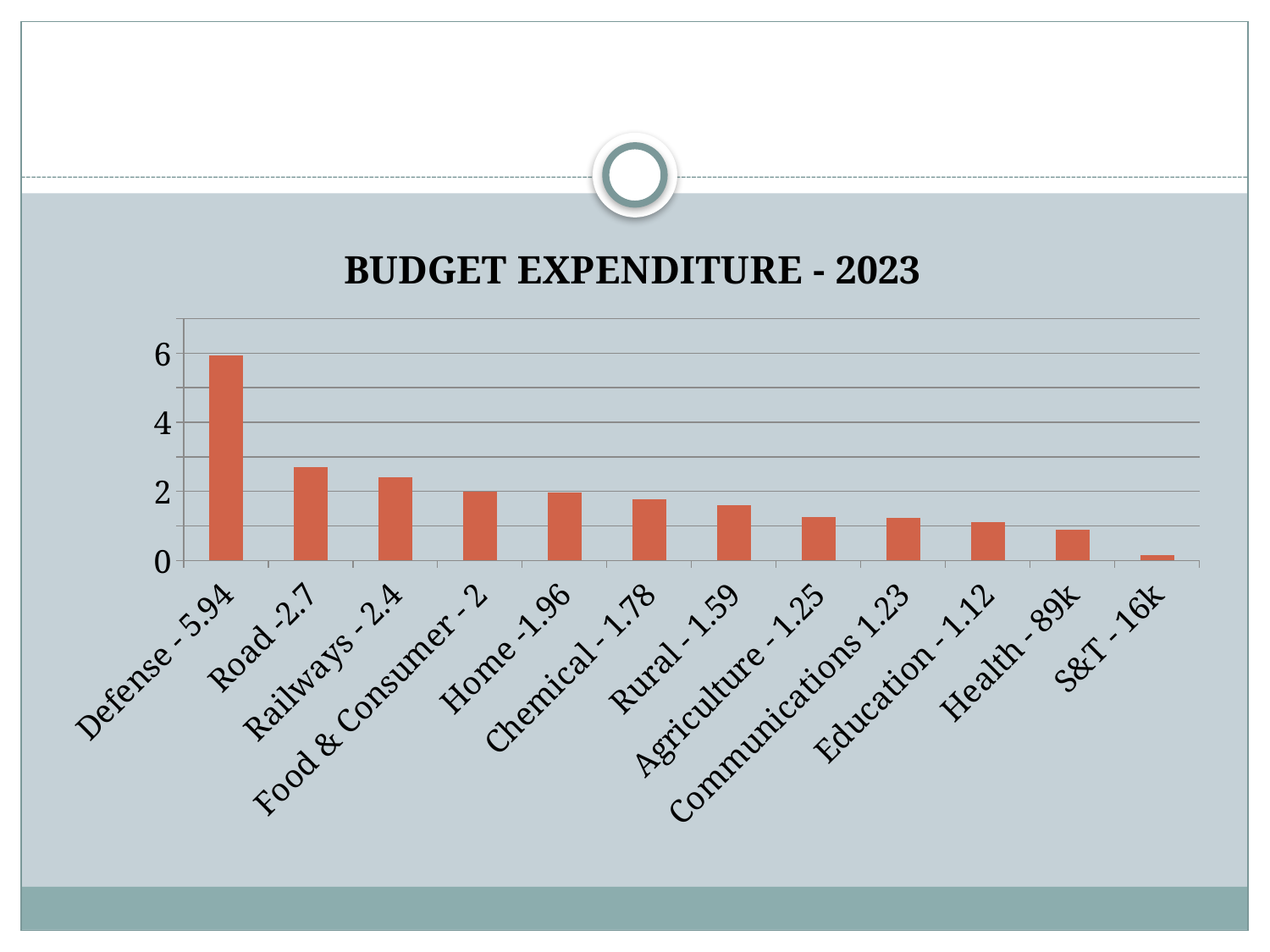
What is the title of the chart? BUDGET EXPENDITURE - 2023 Which is larger, the value for Home or the value for Rural? Home What kind of chart is shown on the slide? bar chart How many categories are plotted in the chart? 12 What is the difference between the values for Defense and Road? 3.24 Which category has the lowest budget expenditure? S&T What is the value shown for Defense? 5.94 Is the value for Agriculture greater or less than 2? less Do the bar values rise or fall from left to right along the x axis? fall Which category has the highest budget expenditure? Defense What is the value shown for Chemical? 1.78 What is the value shown for Railways? 2.4